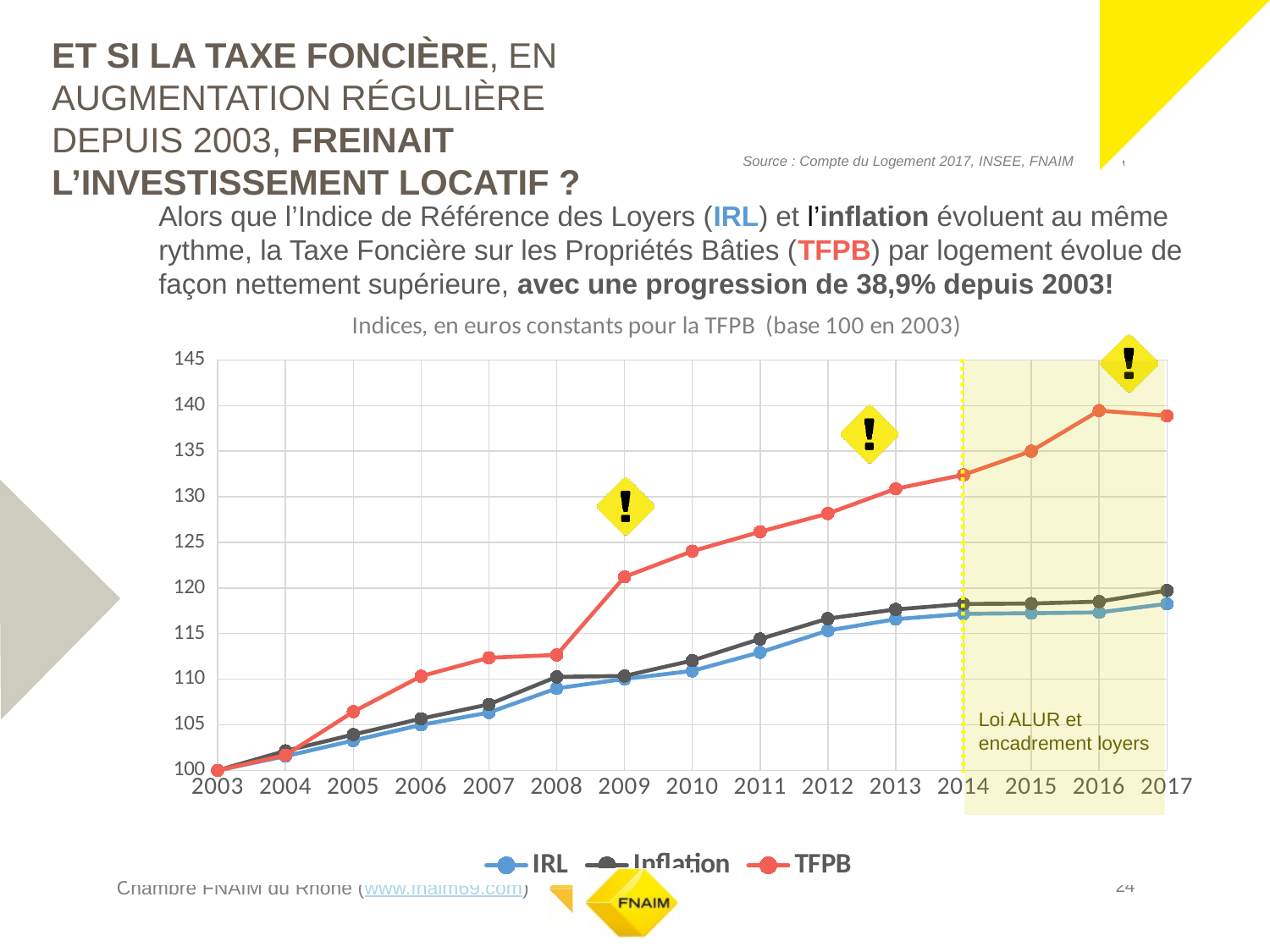
Does the TFPB series rise or fall from 2003 to 2016? rise Is the value for IRL in 2017 greater or less than 120? less What kind of chart is shown on the slide? line chart Which series has the highest value in 2017? TFPB What is the value of the TFPB index in 2003? 100 How many years are plotted along the x axis of the chart? 15 What is the title of the chart? Indices, en euros constants pour la TFPB (base 100 en 2003) Which is larger in 2012, the TFPB value or the IRL value? TFPB How many series does the chart legend list? 3 Which series has the lowest value in 2012? IRL Is the value for TFPB in 2017 greater or less than 135? greater Is the value for TFPB in 2009 greater or less than 115? greater